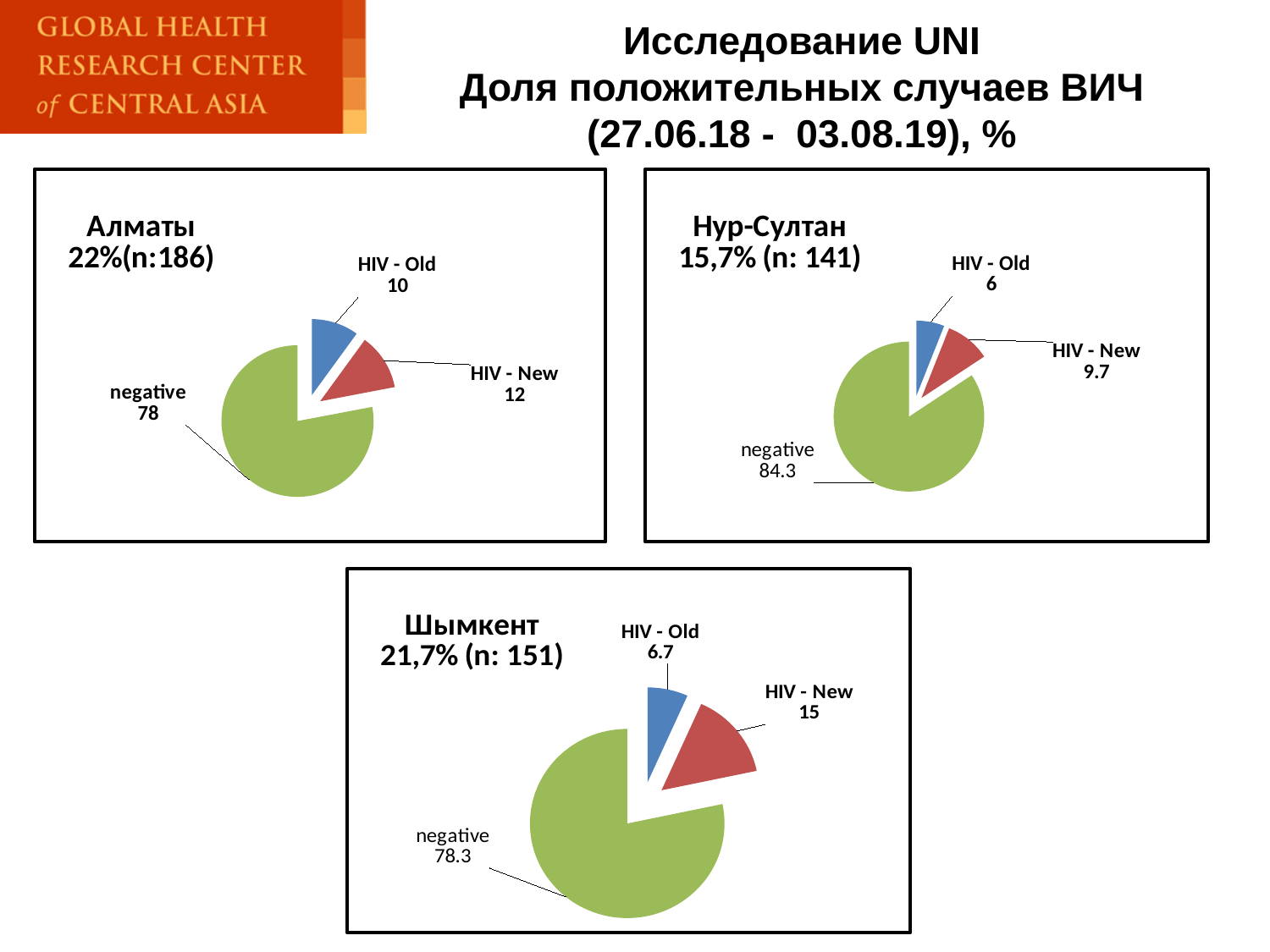
In the Алматы chart, which is larger, HIV - Old or HIV - New? HIV - New In the Шымкент chart, what is the value for HIV - Old? 6.7 In the Нур-Султан chart, what is the value for HIV - Old? 6 In the Нур-Султан chart, which slice is the smallest? HIV - Old In the Алматы chart, what is the value for negative? 78 In the Алматы chart, which slice is the largest? negative In the Нур-Султан chart, what is the value for negative? 84.3 What type of chart is used for Шымкент? Pie chart In the Шымкент chart, what is the difference between HIV - New and HIV - Old? 8.3 In the Алматы chart, what is the value for HIV - New? 12 In the Шымкент chart, what is the value for HIV - New? 15 How many slices does the Нур-Султан chart have? 3